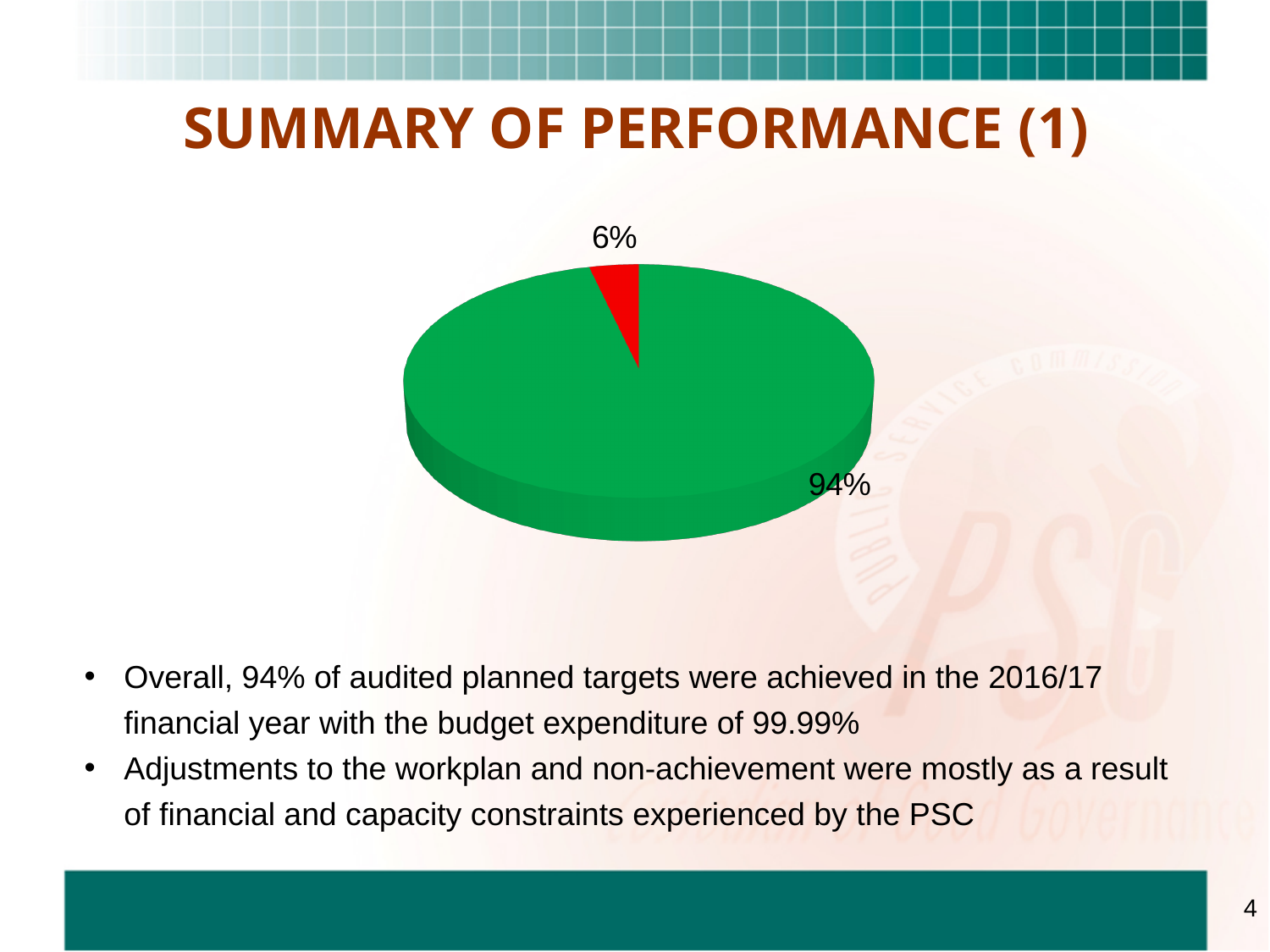
Which is larger, the green slice or the red slice? the green slice What percentage is shown for the green slice of the pie chart? 94% Which slice of the pie chart is the smallest? the red slice (6%) Which slice of the pie chart is the largest? the green slice (94%) What kind of chart is shown on the slide? pie chart Does the pie chart include a legend? No How many slices does the pie chart have? 2 What share of the pie does the green slice represent? 94% What is the difference in percentage points between the green slice and the red slice? 88 What colour is the 6% slice of the pie chart? red What percentage is shown for the red slice of the pie chart? 6%